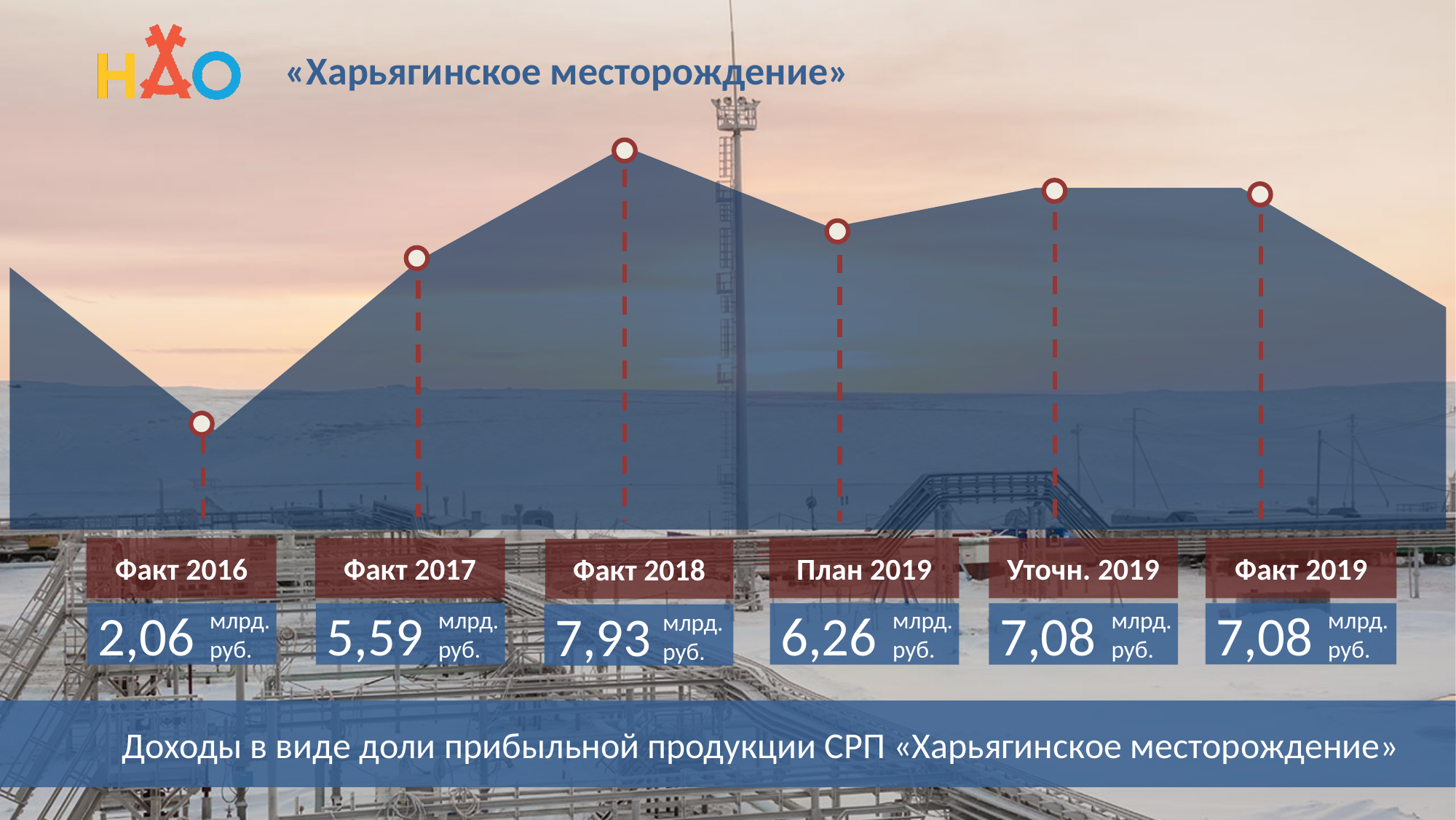
Which is larger, the value for Факт 2017 or the value for План 2019? План 2019 What kind of chart is shown on the slide? Area chart How many data points are plotted on the chart? 6 What is the difference between the values for Факт 2019 and План 2019? 0,82 млрд. руб. What is the difference between the values for Факт 2018 and Факт 2017? 2,34 млрд. руб. What is the value for Факт 2018? 7,93 млрд. руб. What is the value for Факт 2019? 7,08 млрд. руб. What is the value for Факт 2016? 2,06 млрд. руб. Which category has the highest value? Факт 2018 What is the value for План 2019? 6,26 млрд. руб. Do the values rise or fall from Факт 2016 to Факт 2018? Rise Which category has the lowest value? Факт 2016